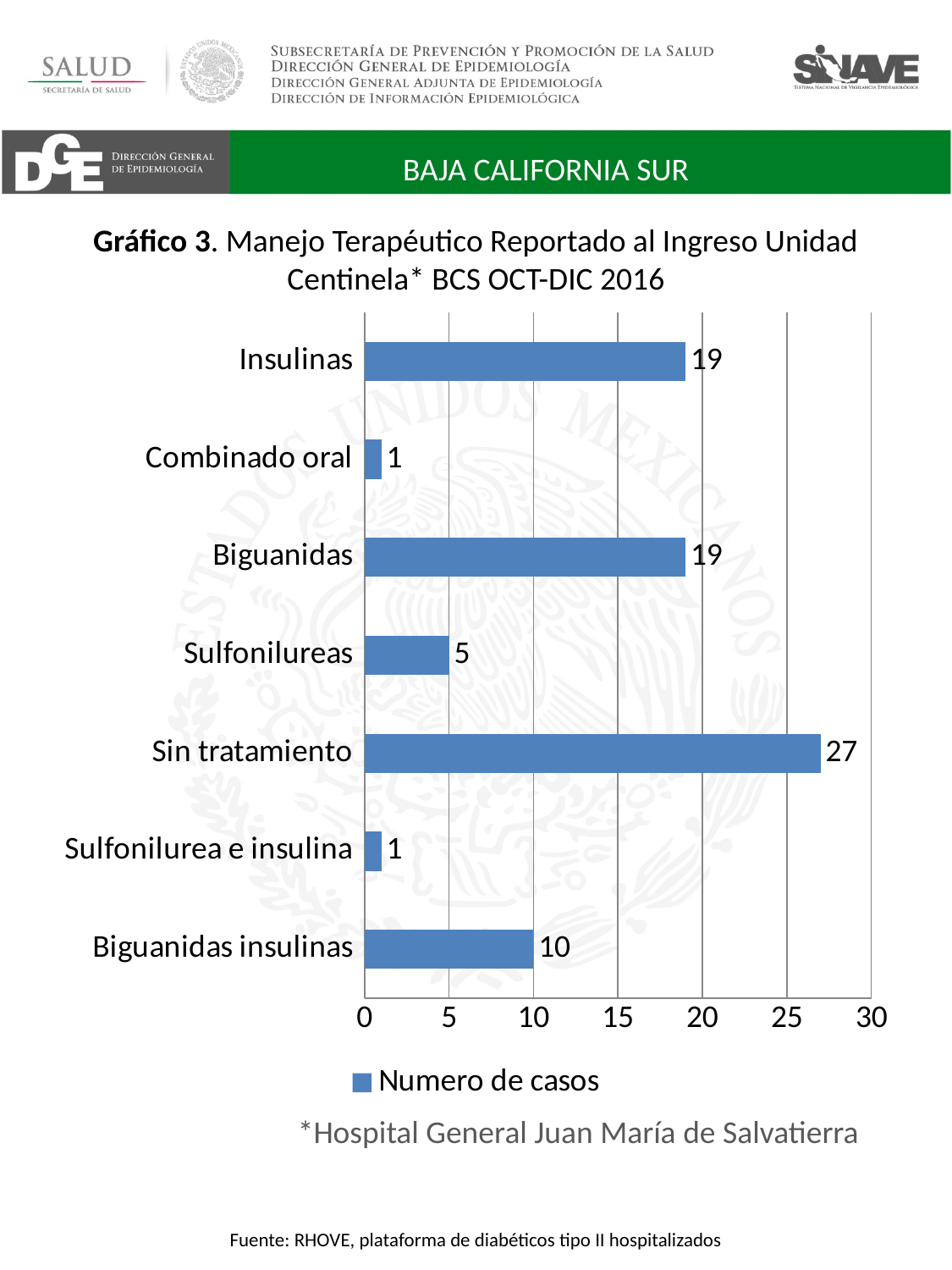
What is the number of cases for Sin tratamiento? 27 Which category has the highest number of cases? Sin tratamiento What series name does the legend show? Numero de casos Which has more cases, Biguanidas or Biguanidas insulinas? Biguanidas Is the value for Sin tratamiento greater or less than 25? greater What kind of chart is shown on the slide? Bar chart What is the difference in number of cases between Sin tratamiento and Insulinas? 8 What is the number of cases for Biguanidas insulinas? 10 What is the number of cases for Combinado oral? 1 What is the number of cases for Sulfonilureas? 5 What is the difference in number of cases between Biguanidas insulinas and Sulfonilureas? 5 How many categories are shown in the chart? 7